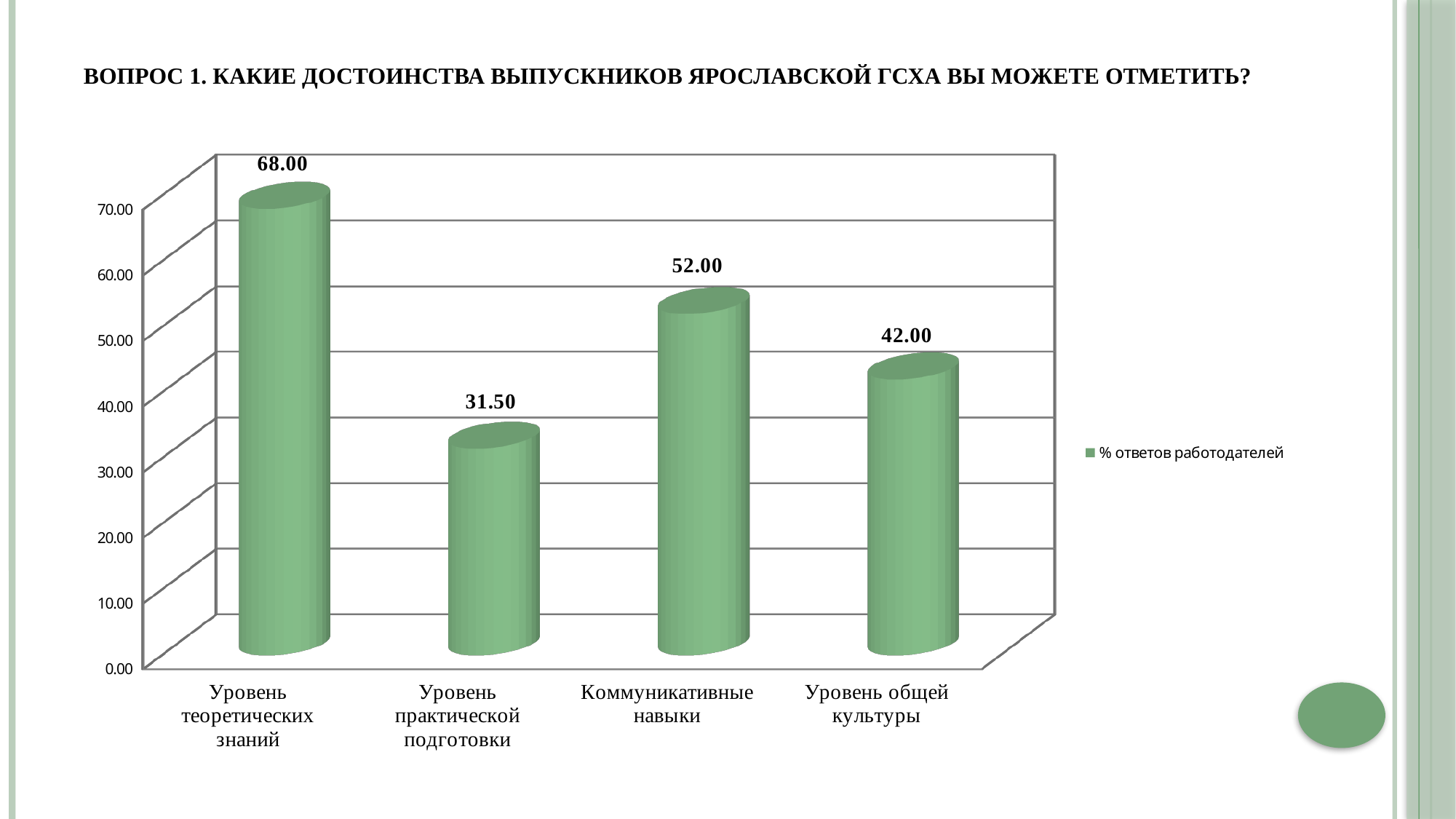
Which is larger, the value for Коммуникативные навыки or the value for Уровень общей культуры? Коммуникативные навыки What is the value for Уровень практической подготовки? 31.50 What is the value for Уровень общей культуры? 42.00 What is the difference between the values for Уровень теоретических знаний and Коммуникативные навыки? 16.00 Which category has the lowest value? Уровень практической подготовки How many categories are shown on the chart? 4 What is the difference between the values for Уровень общей культуры and Уровень практической подготовки? 10.50 What is the value for Коммуникативные навыки? 52.00 Which category has the highest value? Уровень теоретических знаний What is the value for Уровень теоретических знаний? 68.00 What kind of chart is shown on the slide? Bar chart What series name does the legend show? % ответов работодателей